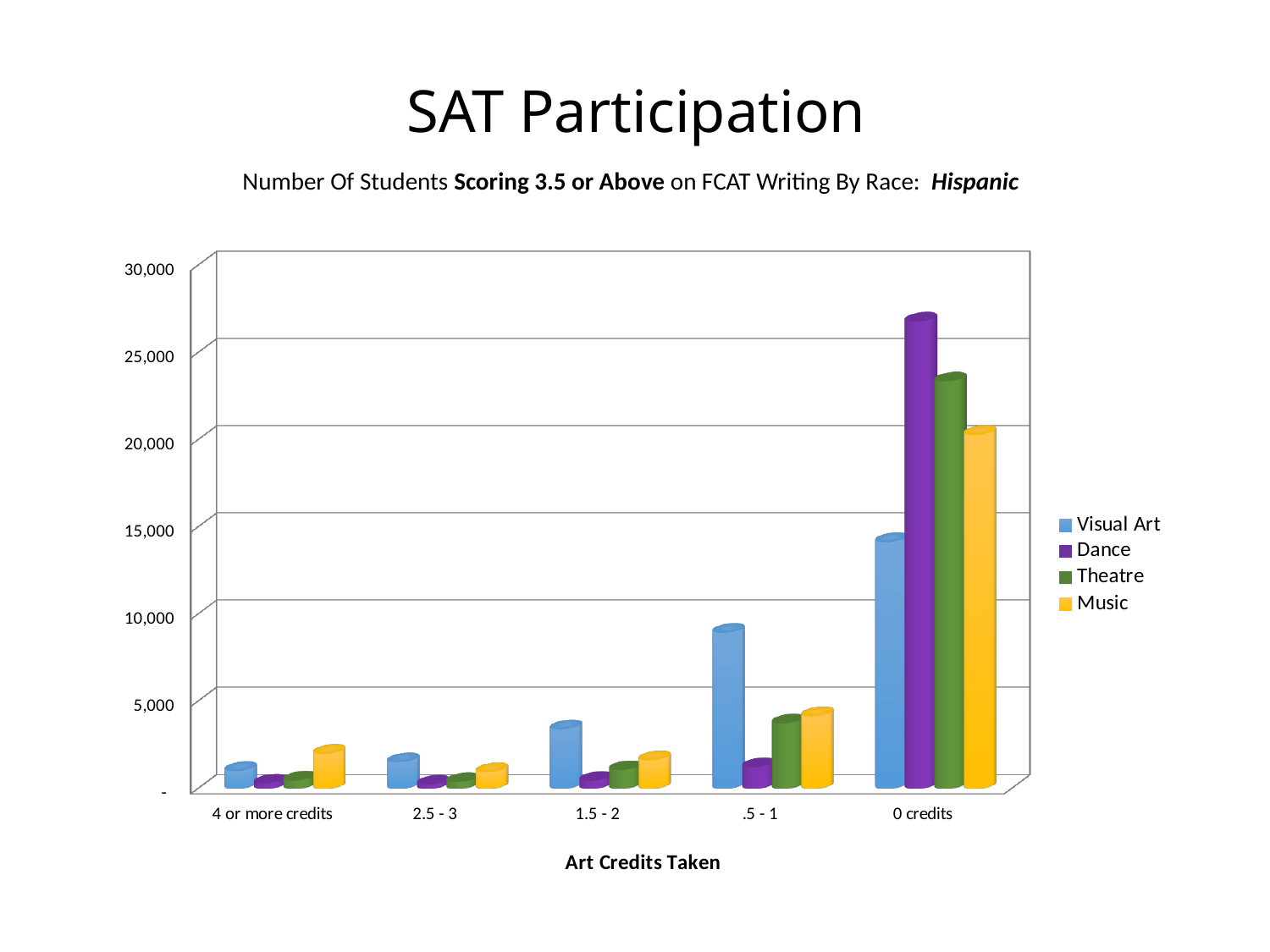
What kind of chart is shown on the slide? bar chart Is the Visual Art value for 0 credits greater or less than 10,000? greater How many series does the legend list? 4 Is the Visual Art value for .5 - 1 credits greater or less than 10,000? less Do the Visual Art values rise or fall moving from 4 or more credits to 0 credits along the x axis? rise What is the title of the x axis? Art Credits Taken Which series has the highest value for the .5 - 1 credits category? Visual Art Which series has the highest value for the 0 credits category? Dance Is the Dance value for 0 credits greater or less than 25,000? greater Which series has the lowest value for the 0 credits category? Visual Art For the 0 credits category, which is larger: Theatre or Music? Theatre How many art-credit categories are shown on the x axis? 5